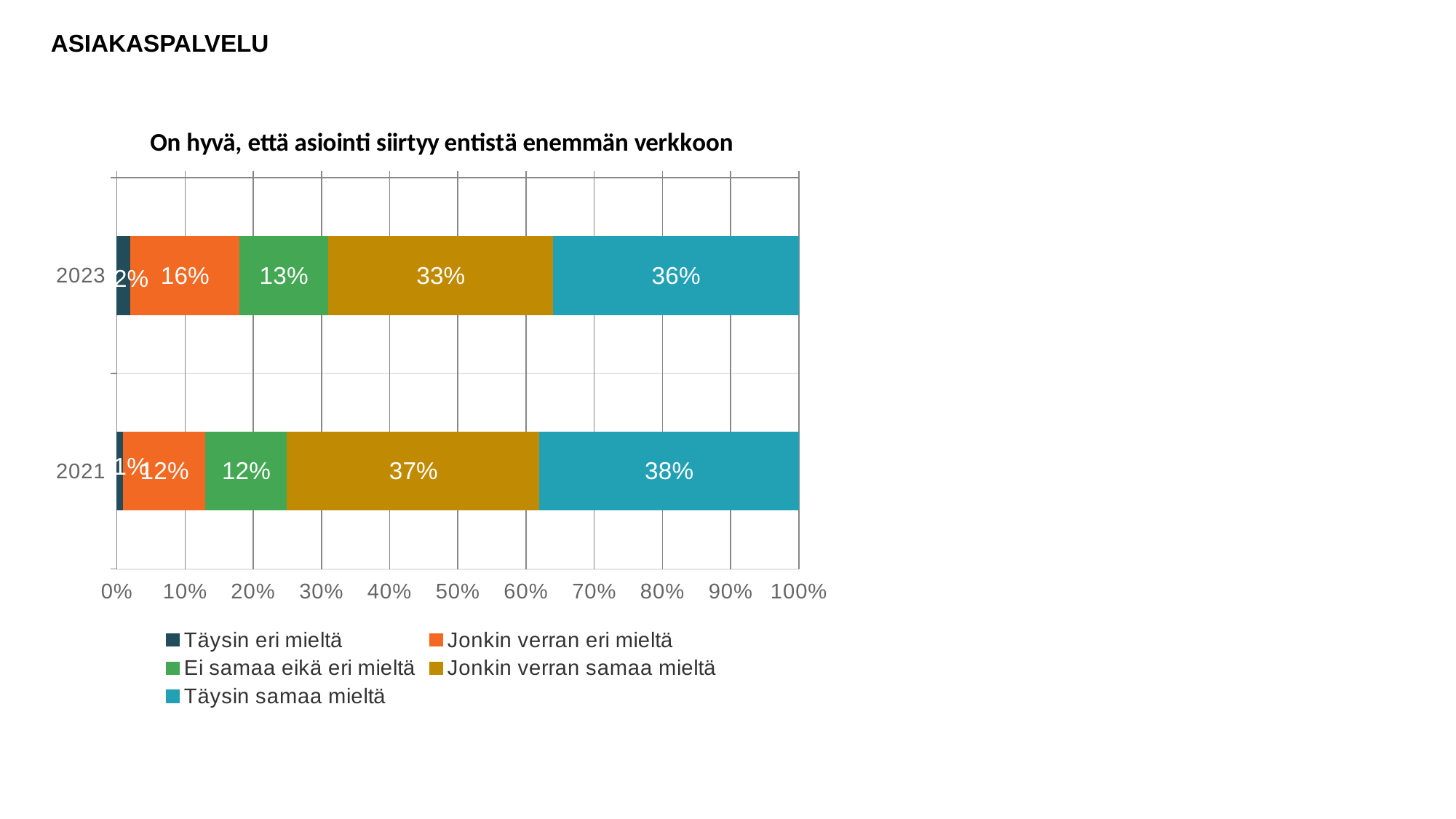
How many categories (years) are shown on the chart? 2 Which is larger: 'Jonkin verran eri mieltä' in 2023 or in 2021? 2023 Which series has the lowest value in 2023? Täysin eri mieltä What is the value for 'Jonkin verran eri mieltä' in 2023? 16% What is the difference between 'Jonkin verran samaa mieltä' in 2021 and in 2023? 4% What is the title of the chart? On hyvä, että asiointi siirtyy entistä enemmän verkkoon How many series does the legend list? 5 Which series has the highest value in 2021? Täysin samaa mieltä What is the value for 'Täysin samaa mieltä' in 2023? 36% What is the value for 'Jonkin verran samaa mieltä' in 2021? 37% What kind of chart is shown on the slide? Stacked bar chart What is the value for 'Ei samaa eikä eri mieltä' in 2021? 12%